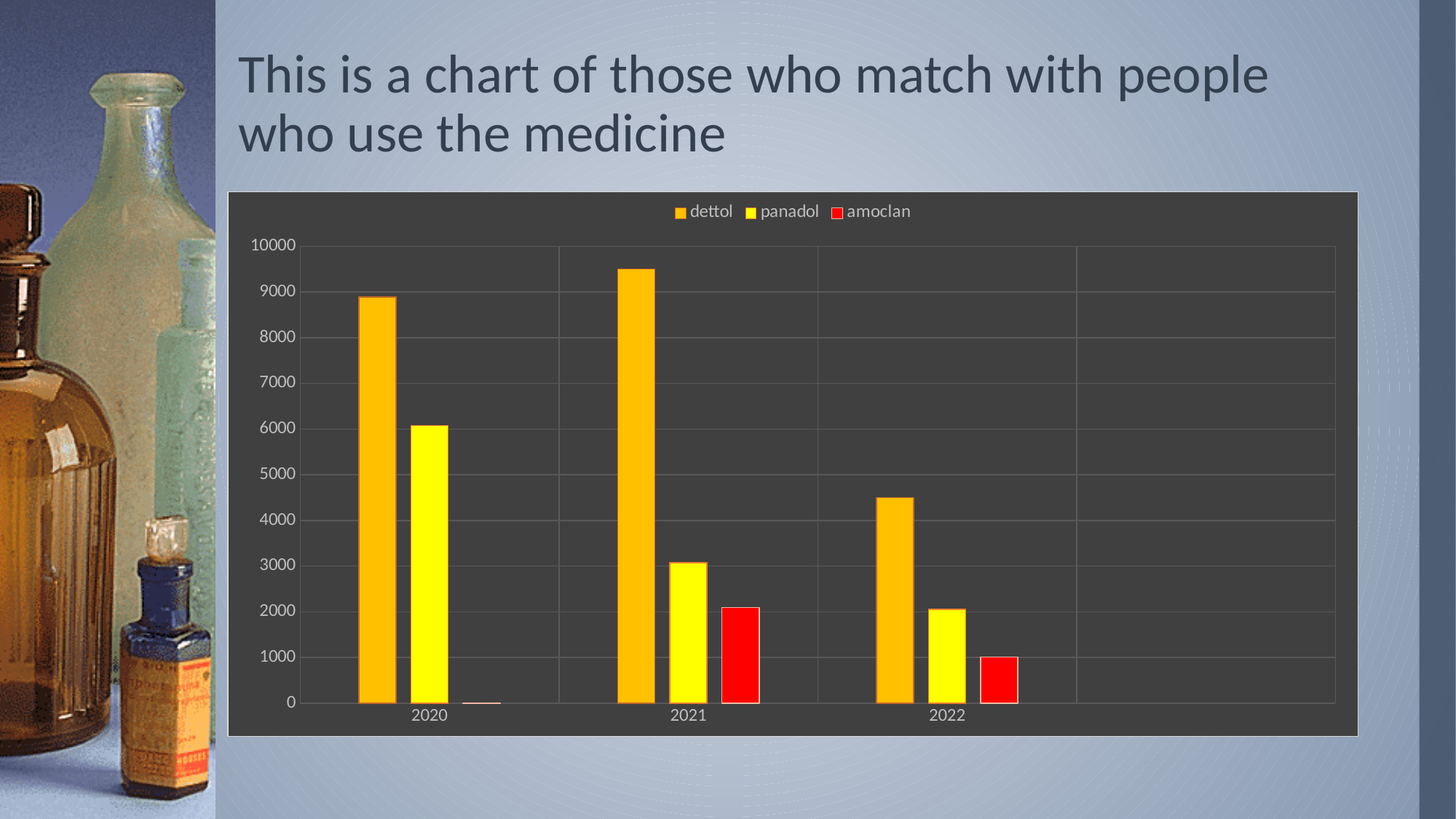
What kind of chart is shown on the slide? bar chart How many years are shown on the x axis? 3 In which year is the dettol bar highest? 2021 Which is larger in 2021, the panadol bar or the amoclan bar? panadol In which year is the panadol bar highest? 2020 Do the panadol values rise or fall from 2020 to 2022? fall Is the value for dettol in 2021 greater or less than 9000? greater Is the value for panadol in 2020 greater or less than 5000? greater Is the value for dettol in 2022 greater or less than 5000? less How many series does the legend list? 3 Which series is shown in red in the legend? amoclan In which year is the dettol bar lowest? 2022